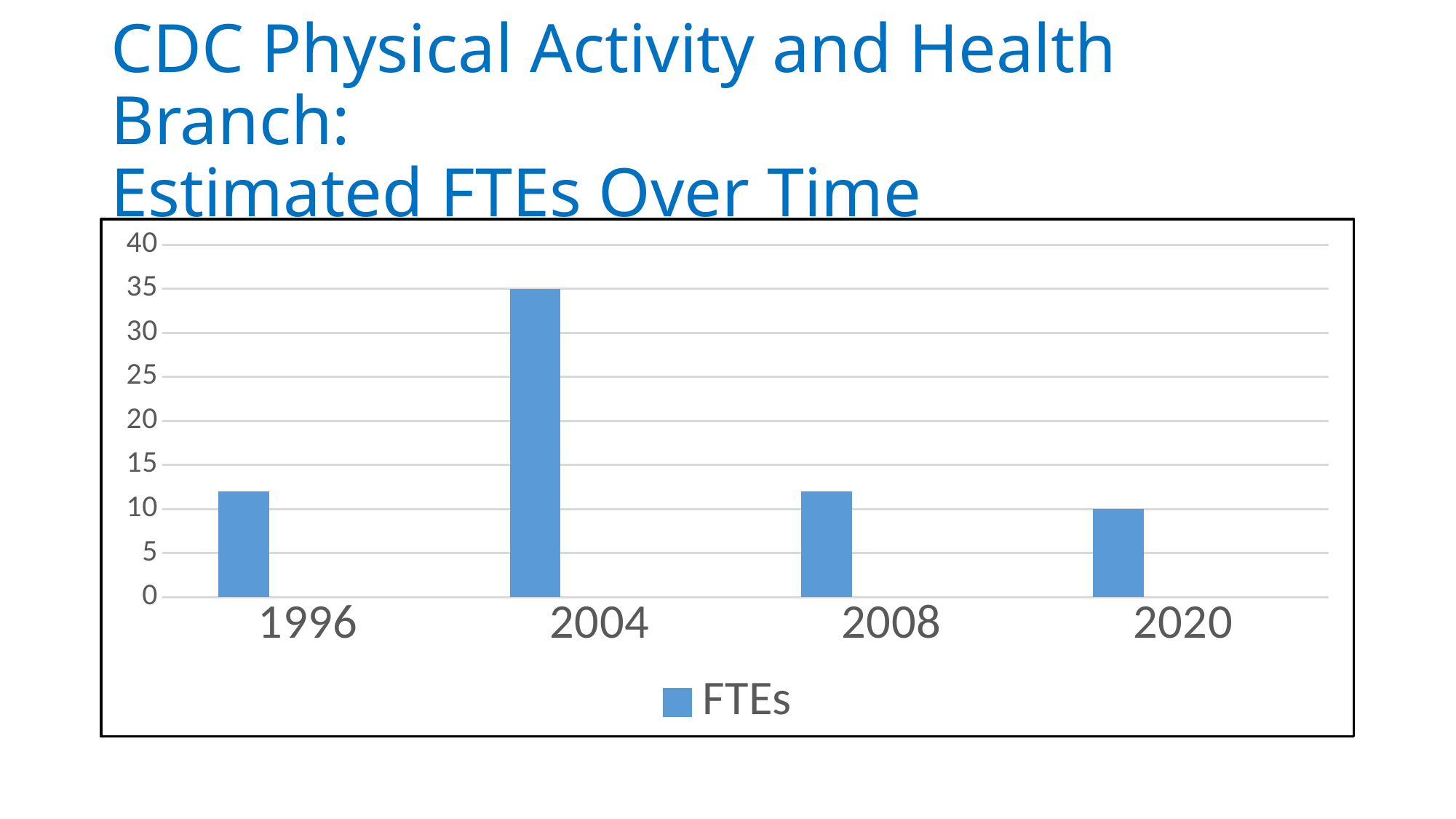
What type of chart is shown on the slide? bar chart What is the value for 2004? 35 What is the name of the series shown in the legend? FTEs Which year has the highest value? 2004 How many series does the chart's legend list? 1 Which is larger, the value for 2004 or the value for 2008? 2004 What is the value for 2020? 10 Which year has the lowest value? 2020 Is the value for 1996 greater or less than 15? less Is the value for 2008 greater or less than 10? greater What is the difference between the values for 2004 and 2020? 25 How many years are shown on the x axis of the chart? 4